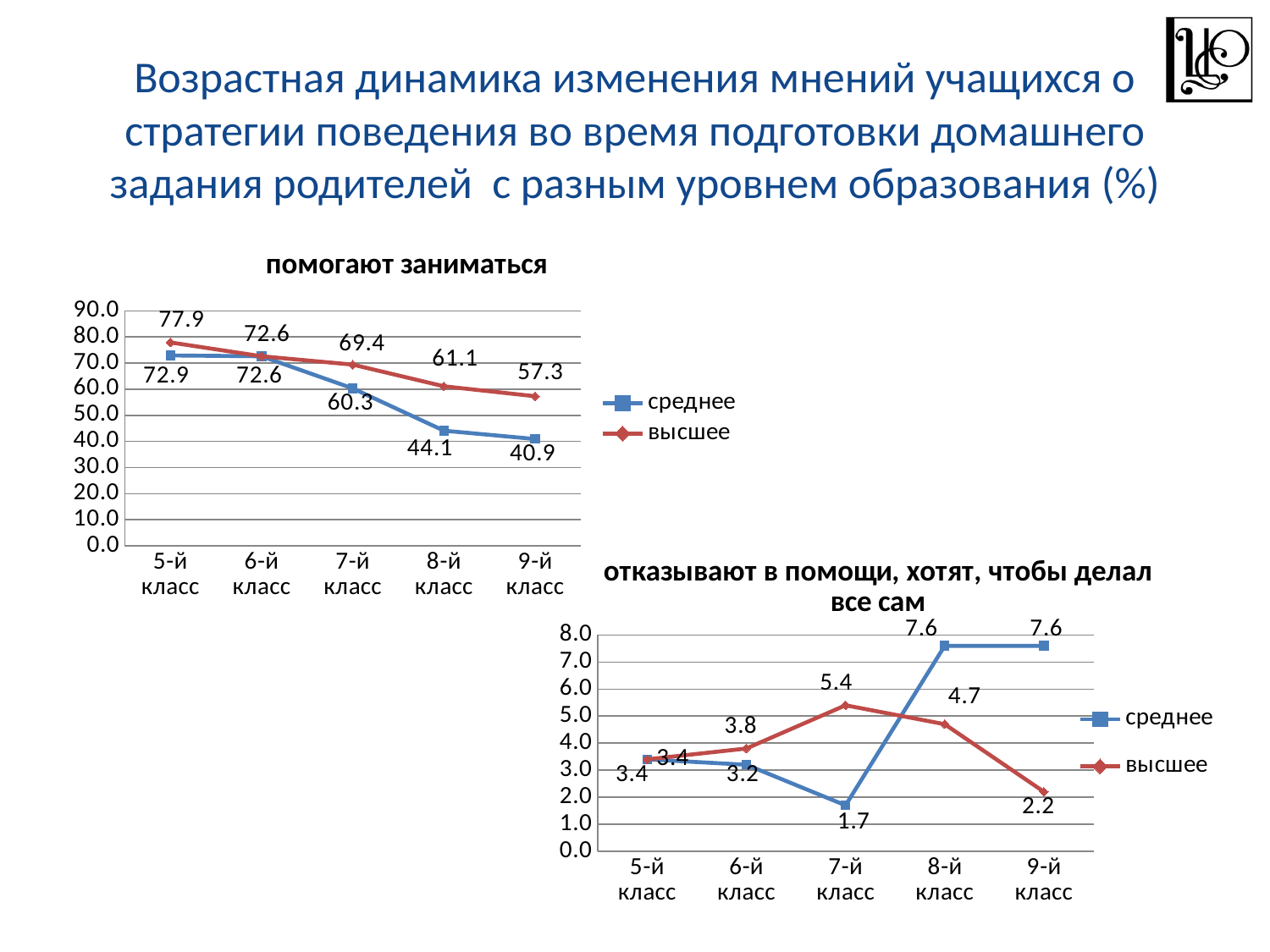
In the chart titled "отказывают в помощи, хотят, чтобы делал все сам", what is the value for "среднее" in 7-й класс? 1.7 In the chart titled "отказывают в помощи, хотят, чтобы делал все сам", how many classes are shown on the x axis? 5 What kind of chart is the chart titled "отказывают в помощи, хотят, чтобы делал все сам"? line chart In the chart titled "помогают заниматься", what is the value for "высшее" in 5-й класс? 77.9 In the chart titled "отказывают в помощи, хотят, чтобы делал все сам", in which class is the "высшее" series highest? 7-й класс In the chart titled "помогают заниматься", what is the difference between "высшее" and "среднее" in 8-й класс? 17.0 In the chart titled "помогают заниматься", does the "высшее" series rise or fall from 5-й класс to 9-й класс? fall In the chart titled "помогают заниматься", in which class is the "среднее" series lowest? 9-й класс In the chart titled "помогают заниматься", what is the value for "среднее" in 9-й класс? 40.9 In the chart titled "отказывают в помощи, хотят, чтобы делал все сам", which series has the larger value in 9-й класс, "среднее" or "высшее"? среднее In the chart titled "помогают заниматься", how many series does the legend list? 2 In the chart titled "отказывают в помощи, хотят, чтобы делал все сам", what is the value for "высшее" in 7-й класс? 5.4